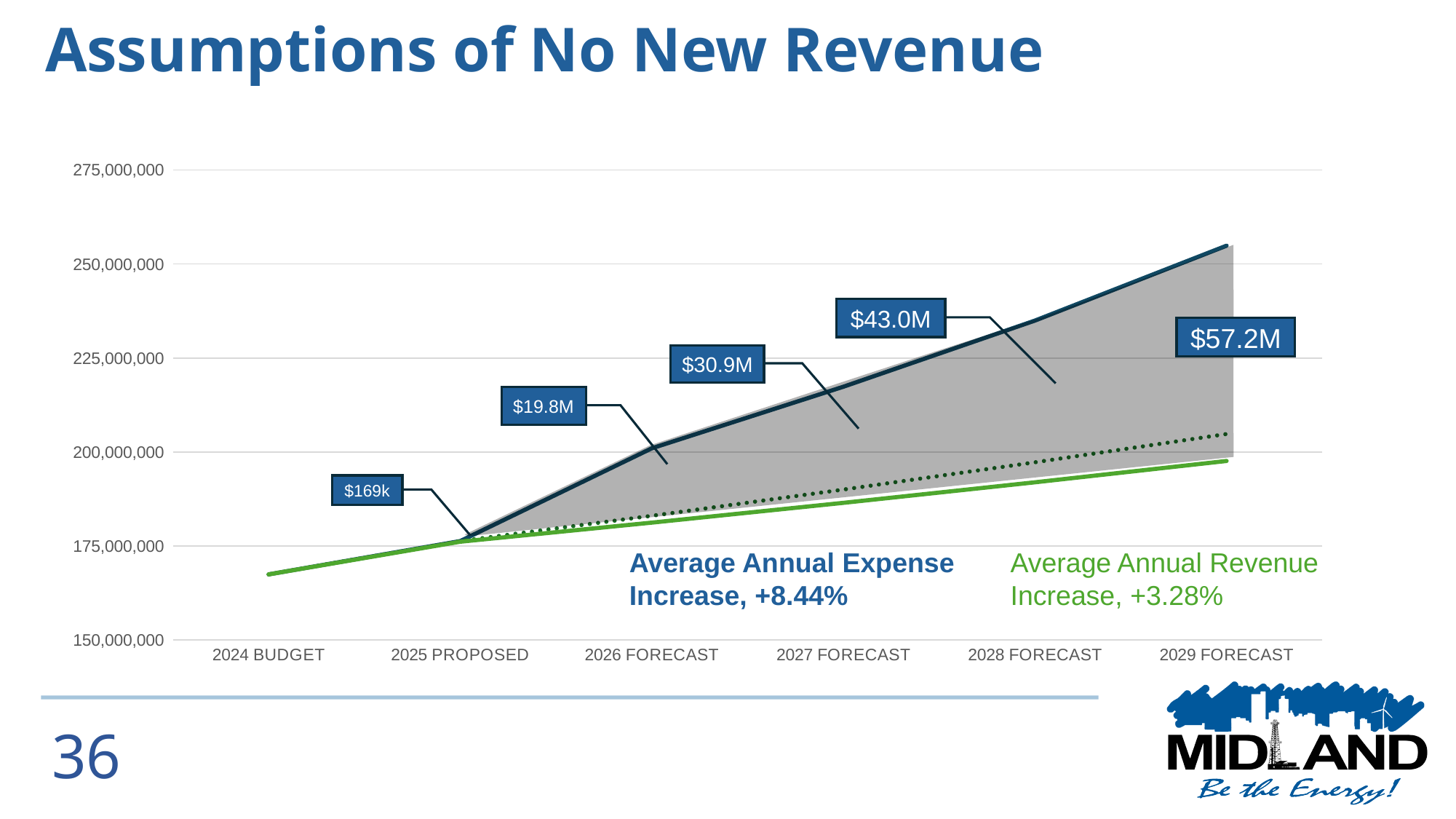
What gap value is labelled at 2027 FORECAST? $30.9M What gap value is labelled at 2026 FORECAST? $19.8M What kind of chart is shown on the slide? line chart What is the title of the chart on this slide? Assumptions of No New Revenue Is the value of the dark blue expense line at 2029 FORECAST greater or less than 250,000,000? greater What is the difference between the labelled gap at 2029 FORECAST and the labelled gap at 2028 FORECAST? $14.2M How many categories are shown along the x axis? 6 What gap value is labelled at 2029 FORECAST? $57.2M What gap value is labelled at 2025 PROPOSED? $169k Does the dark blue expense line rise or fall from 2024 BUDGET to 2029 FORECAST? rise Which forecast year has the largest labelled gap between expenses and revenue? 2029 FORECAST What gap value is labelled at 2028 FORECAST? $43.0M